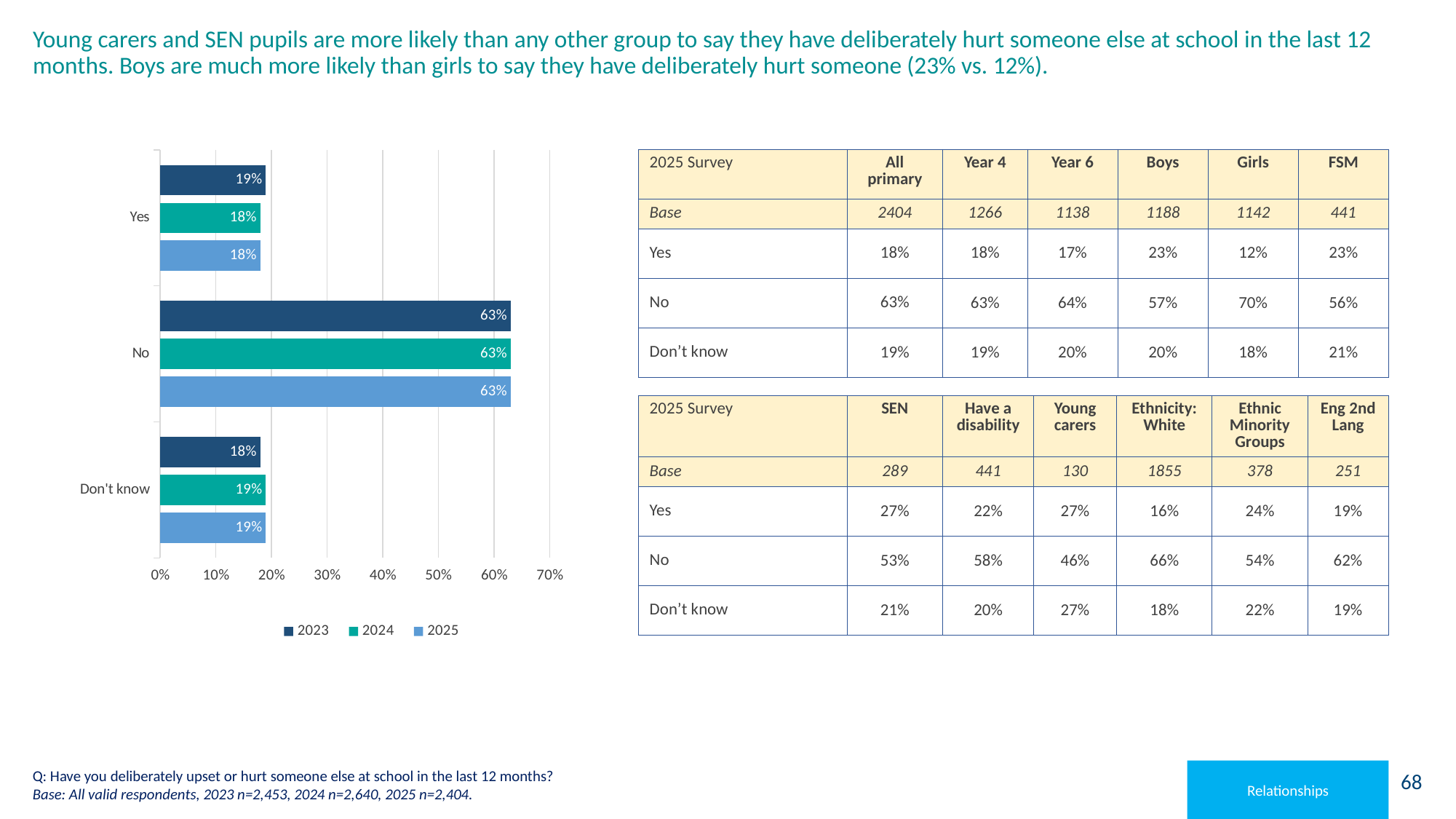
What is the value for 'Don't know' in 2024? 19% What kind of chart is shown on the slide? Bar chart Is the value for 'No' in 2023 greater or less than 60%? greater How many categories are shown on the chart? 3 What is the value for 'No' in 2025? 63% How many series does the legend list? 3 What is the value for 'Yes' in 2025? 18% Which category has the highest value in 2024? No Is the value for 'Yes' in 2024 greater or less than 20%? less What is the difference between the 'No' and 'Yes' values in 2023? 44% Which years are listed in the chart legend? 2023, 2024, 2025 What is the value for 'Yes' in 2023? 19%